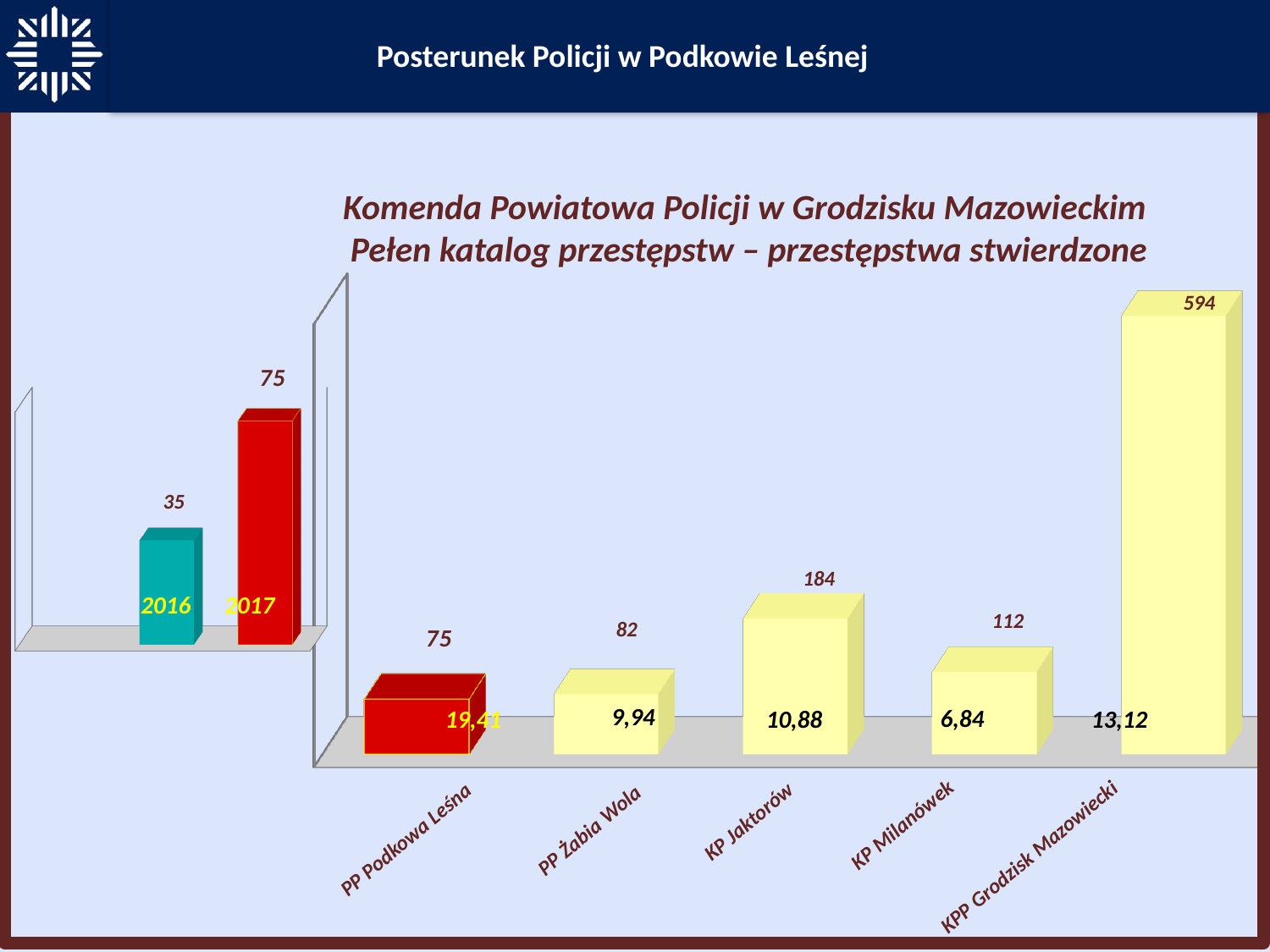
In the small chart on the left, what is the value for 2016? 35 In the large chart on the right, what is the lower label printed on the bar for KP Milanówek? 6,84 In the large chart on the right, which is larger, the value for KP Milanówek or PP Żabia Wola? KP Milanówek How many categories are shown in the large chart on the right? 5 In the large chart on the right, which category has the lowest value? PP Podkowa Leśna In the large chart on the right, what is the value for KPP Grodzisk Mazowiecki? 594 In the small chart on the left, what is the difference between the 2017 and 2016 values? 40 In the large chart on the right, what is the difference between the values for KP Jaktorów and KP Milanówek? 72 In the large chart on the right, what is the value for PP Żabia Wola? 82 In the large chart on the right, which category has the highest value? KPP Grodzisk Mazowiecki In the large chart on the right, what is the value for KP Jaktorów? 184 What type of chart is the large chart on the right? Bar chart